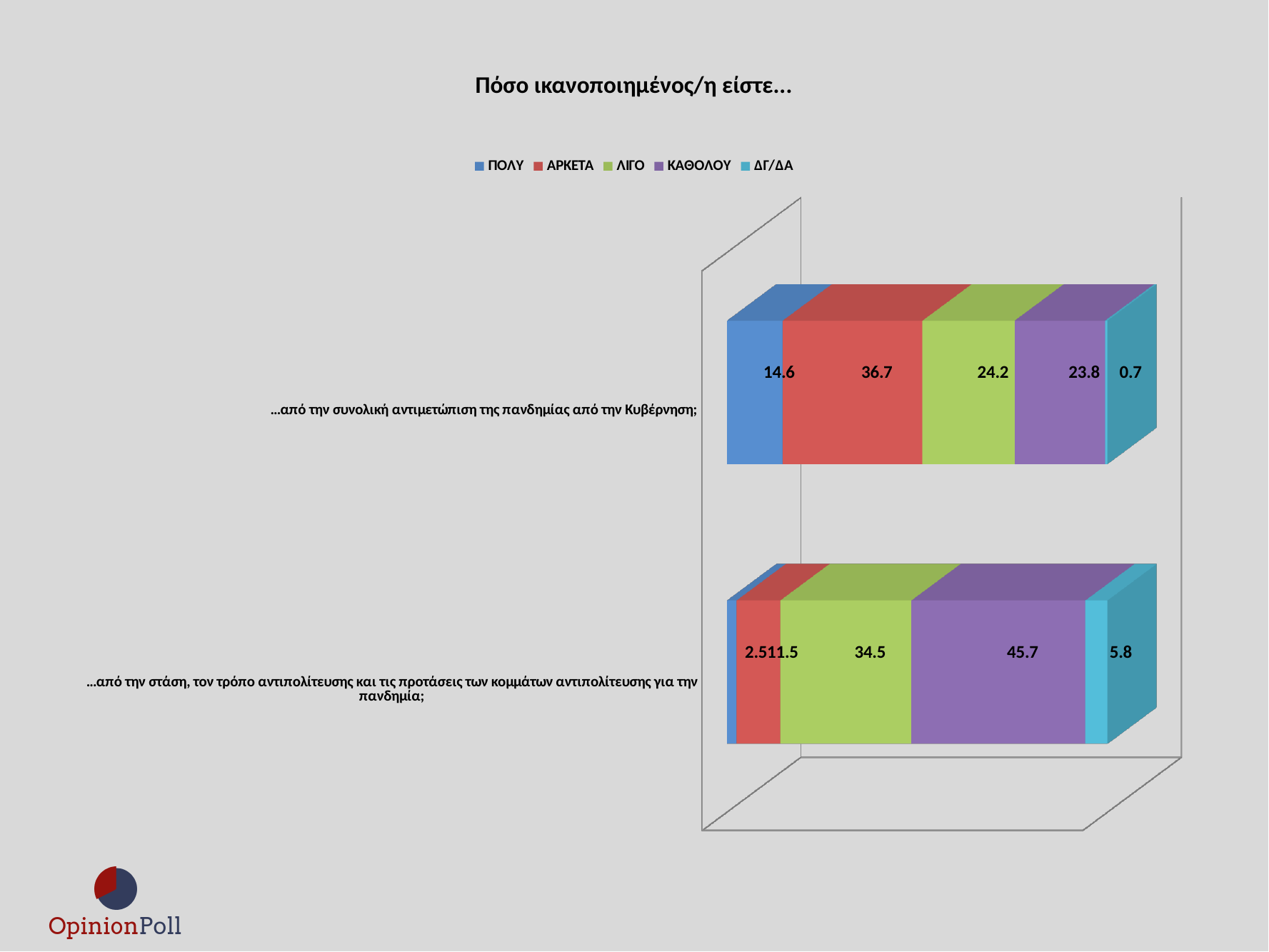
What is the ΚΑΘΟΛΟΥ value for the category '...από την στάση, τον τρόπο αντιπολίτευσης και τις προτάσεις των κομμάτων αντιπολίτευσης για την πανδημία;'? 45.7 Which series has the smallest value in the bar for '...από την στάση, τον τρόπο αντιπολίτευσης και τις προτάσεις των κομμάτων αντιπολίτευσης για την πανδημία;'? ΠΟΛΥ What is the ΔΓ/ΔΑ value for the category '...από την συνολική αντιμετώπιση της πανδημίας από την Κυβέρνηση;'? 0.7 Which category has the larger ΛΙΓΟ value: the one about the Government ('...από την Κυβέρνηση;') or the one about the opposition parties ('...των κομμάτων αντιπολίτευσης...')? The one about the opposition parties What kind of chart is shown on the slide? Stacked bar chart What is the total of the stacked bar for '...από την συνολική αντιμετώπιση της πανδημίας από την Κυβέρνηση;'? 100.0 Which series has the largest value in the bar for '...από την συνολική αντιμετώπιση της πανδημίας από την Κυβέρνηση;'? ΑΡΚΕΤΑ How many series does the legend list? 5 What is the ΑΡΚΕΤΑ value for the category '...από την συνολική αντιμετώπιση της πανδημίας από την Κυβέρνηση;'? 36.7 What is the title of the chart? Πόσο ικανοποιημένος/η είστε... How many categories (bars) are plotted in the chart? 2 What is the difference between the ΚΑΘΟΛΟΥ values of the two categories? 21.9